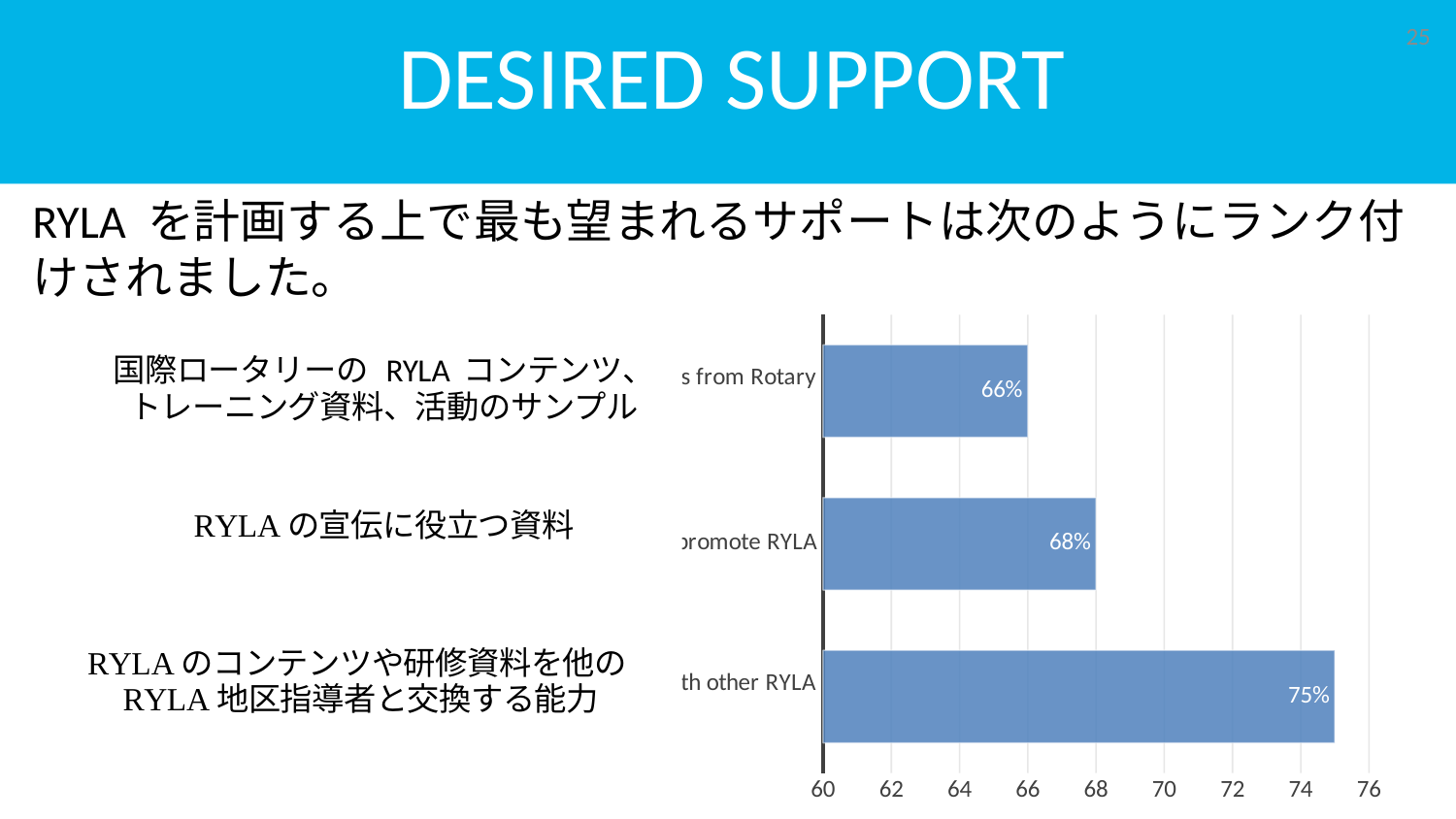
What is the title of the slide containing the chart? DESIRED SUPPORT Which bar has the highest value? the bottom bar (...th other RYLA) What is the difference between the middle bar (68%) and the top bar (66%)? 2% Which bar has the lowest value? the top bar (...s from Rotary) What is the difference between the bottom bar (75%) and the top bar (66%)? 9% Which is larger, the value of the middle bar (...romote RYLA) or the top bar (...s from Rotary)? the middle bar (...romote RYLA) What is the value of the middle bar (labelled "...romote RYLA")? 68% What is the value of the top bar (labelled "...s from Rotary")? 66% How many bars are plotted in the chart? 3 Is the value of the bottom bar (...th other RYLA) greater or less than 70? greater What type of chart is shown on the slide? bar chart What is the value of the bottom bar (labelled "...th other RYLA")? 75%